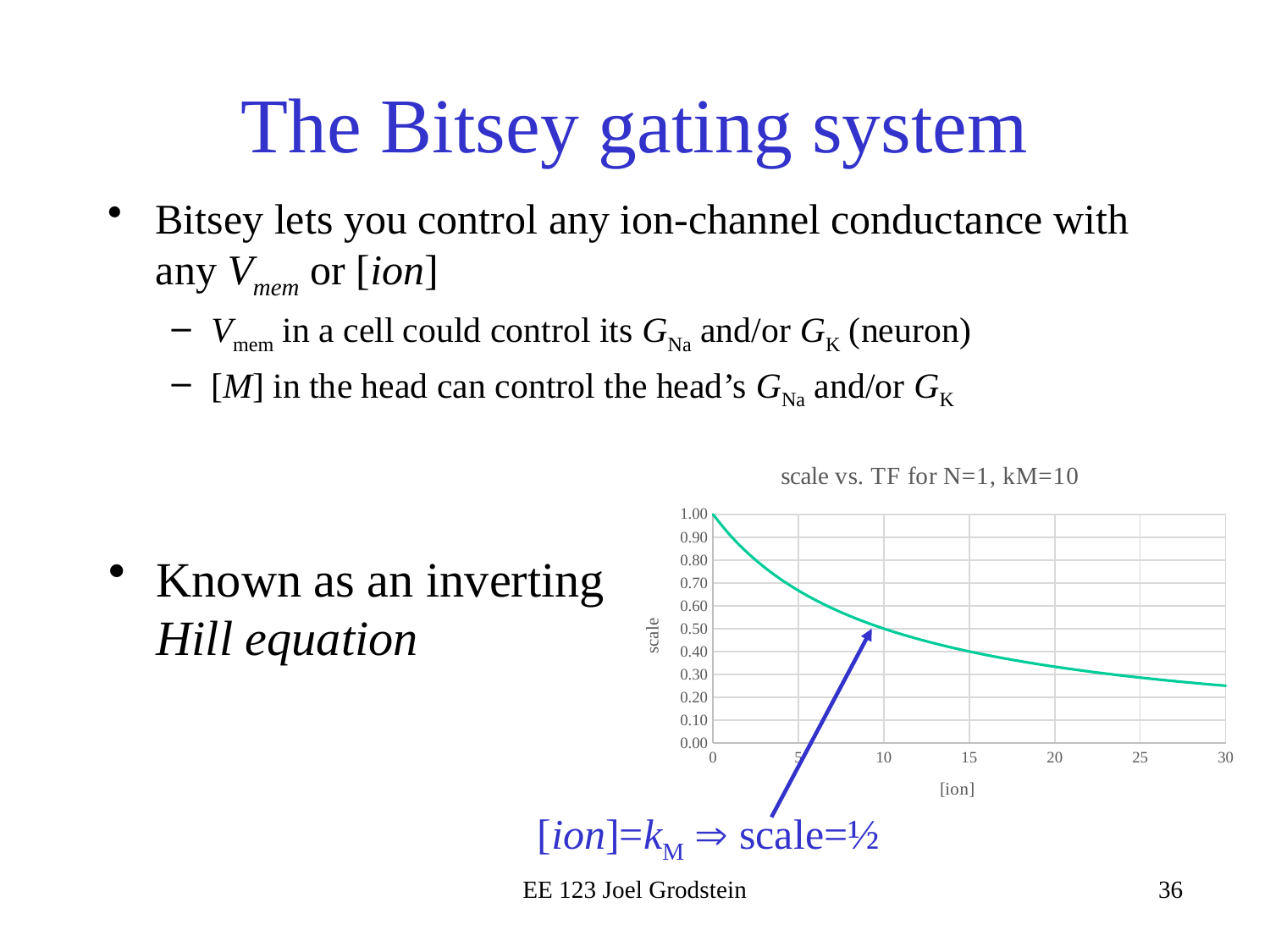
What is the scale value when [ion] is 0? 1.00 Is the scale value at [ion]=5 greater or less than 0.60? greater Is the scale value at [ion]=15 greater or less than 0.50? less Does the scale value rise or fall as [ion] increases along the x axis? fall What type of chart is shown on the slide? line chart Which has the larger scale value: [ion]=5 or [ion]=25? [ion]=5 At which [ion] value shown on the x axis is the scale highest? 0 Is the scale value at [ion]=20 greater or less than 0.40? less What is the title of the chart? scale vs. TF for N=1, kM=10 What is the label of the x axis of the chart? [ion] What is the scale value when [ion] equals kM (10)? 0.50